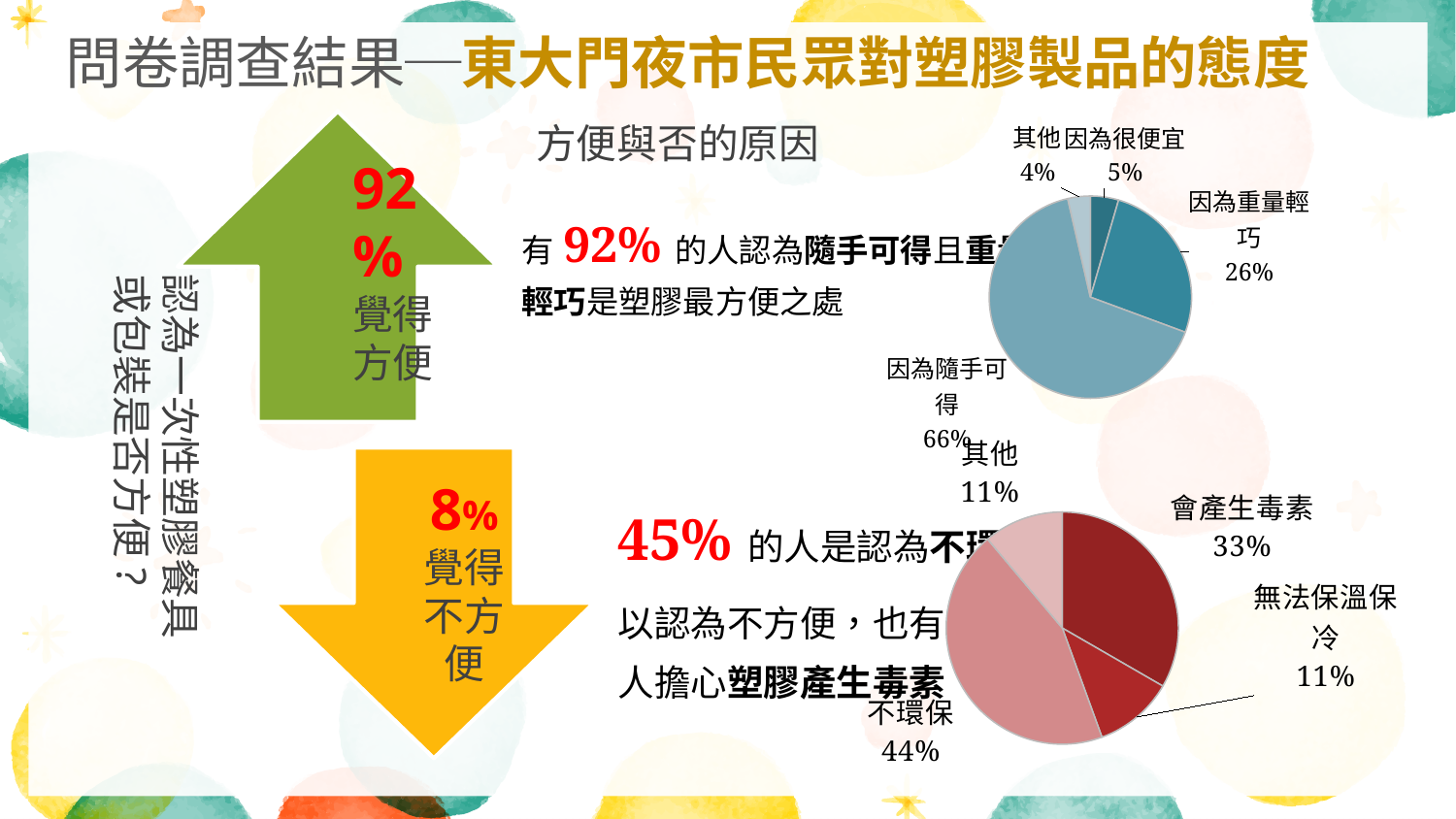
In the pie chart at the lower right of the slide, which is larger, 會產生毒素 or 無法保溫保冷? 會產生毒素 In the pie chart titled 方便與否的原因, what share is labelled 因為很便宜? 5% In the pie chart at the lower right of the slide, what share is labelled 不環保? 44% In the pie chart at the lower right of the slide, what share is labelled 會產生毒素? 33% In the pie chart titled 方便與否的原因, which category has the largest slice? 因為隨手可得 In the pie chart titled 方便與否的原因, which category has the smallest slice? 其他 What type of chart is used to show 方便與否的原因? Pie chart In the pie chart titled 方便與否的原因, how many slices are there? 4 In the pie chart titled 方便與否的原因, what share is labelled 因為隨手可得? 66% In the pie chart titled 方便與否的原因, what share is labelled 因為重量輕巧? 26% In the pie chart titled 方便與否的原因, what is the difference between the 因為隨手可得 share and the 因為重量輕巧 share? 40% In the pie chart at the lower right of the slide, which category has the largest slice? 不環保